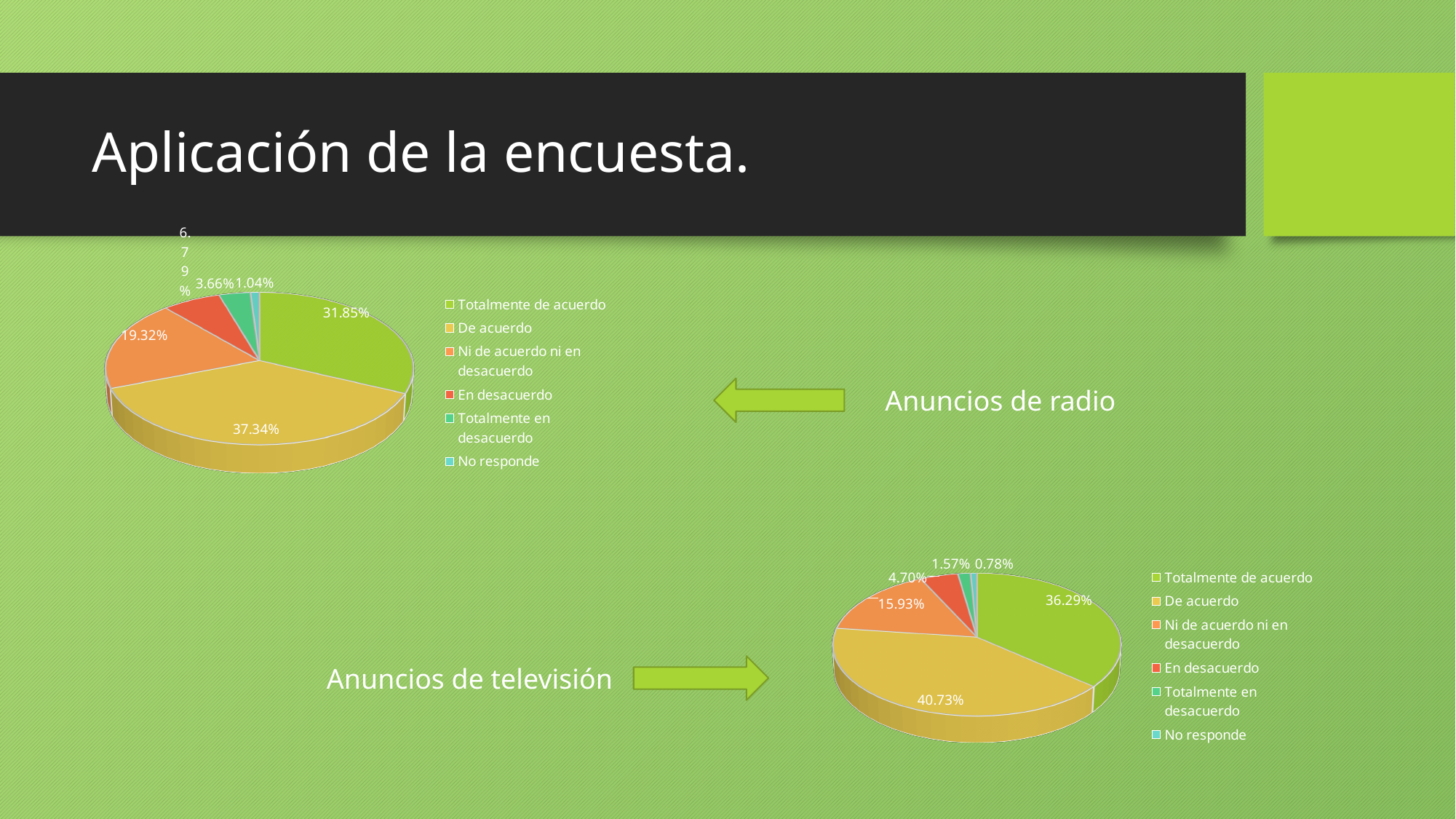
In the Anuncios de radio pie chart, what share does De acuerdo have? 37.34% How many categories does the Anuncios de televisión pie chart have? 6 In the Anuncios de televisión pie chart, what share does No responde have? 0.78% What type of chart is used for Anuncios de radio? Pie chart In the Anuncios de radio pie chart, what colour is the Totalmente de acuerdo slice? Green In the Anuncios de televisión pie chart, which category has the smallest slice? No responde In the Anuncios de radio pie chart, which category has the largest slice? De acuerdo In the Anuncios de televisión pie chart, what share does Totalmente de acuerdo have? 36.29% Which is larger: En desacuerdo in the Anuncios de radio chart or En desacuerdo in the Anuncios de televisión chart? Anuncios de radio In the Anuncios de radio pie chart, what share does Ni de acuerdo ni en desacuerdo have? 19.32% In the Anuncios de televisión pie chart, what is the difference between De acuerdo and Totalmente de acuerdo? 4.44% In the Anuncios de radio pie chart, what is the difference between Totalmente de acuerdo and Ni de acuerdo ni en desacuerdo? 12.53%